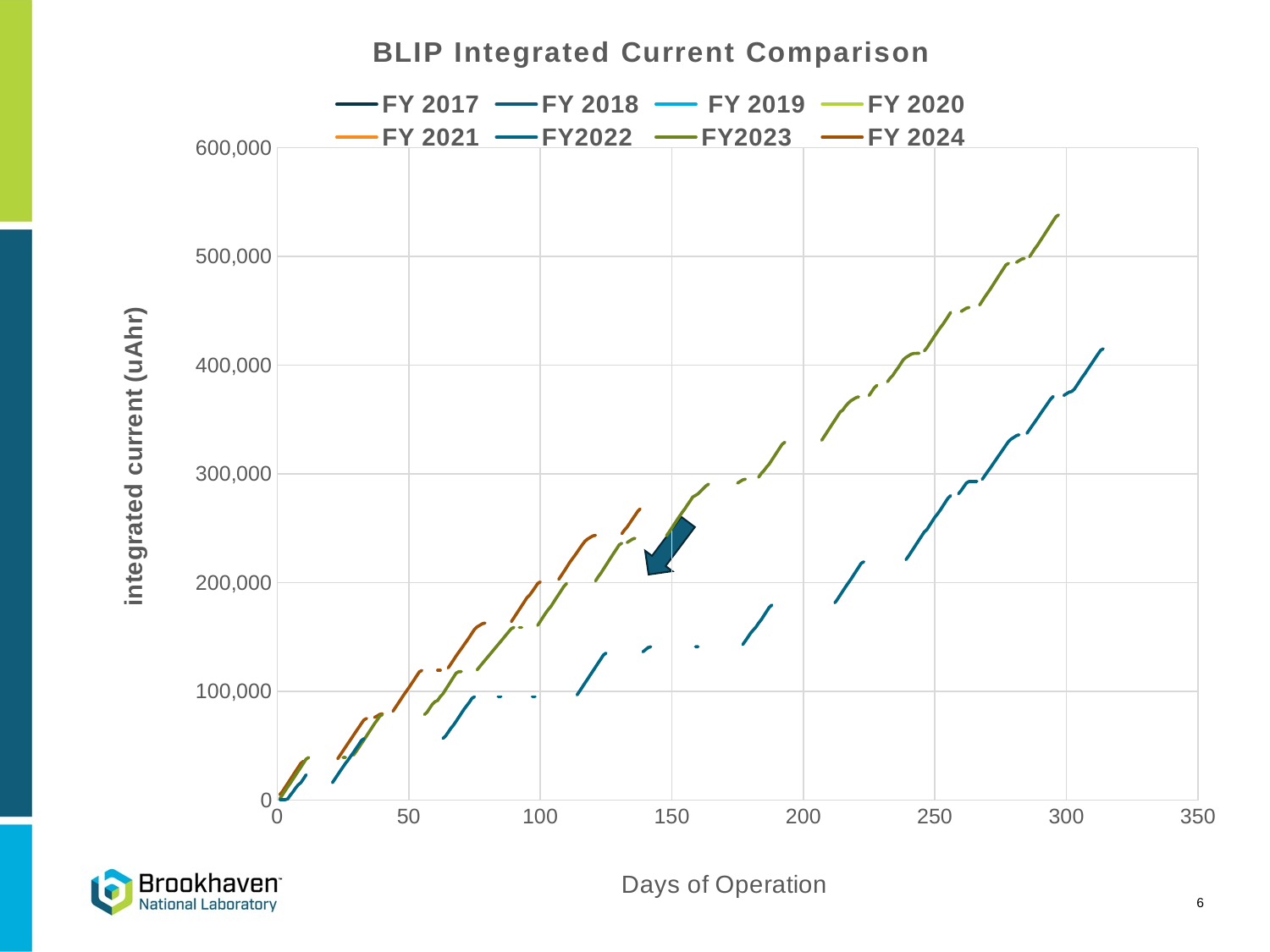
Is the final value of the FY 2024 line greater or less than 300,000? less Is the final value of the FY2022 line greater or less than 300,000? greater What is the title of the chart? BLIP Integrated Current Comparison Which series reaches a higher integrated current, FY2023 or FY2022? FY2023 Is the final value of the FY2022 line greater or less than 500,000? less How many series does the legend of the BLIP Integrated Current Comparison chart list? 8 What is the label of the x axis? Days of Operation Do the plotted lines rise or fall as days of operation increase? rise What type of chart is shown on the slide? line chart Which series reaches a higher integrated current, FY 2024 or FY2022? FY2022 Which series reaches the highest integrated current on the chart? FY2023